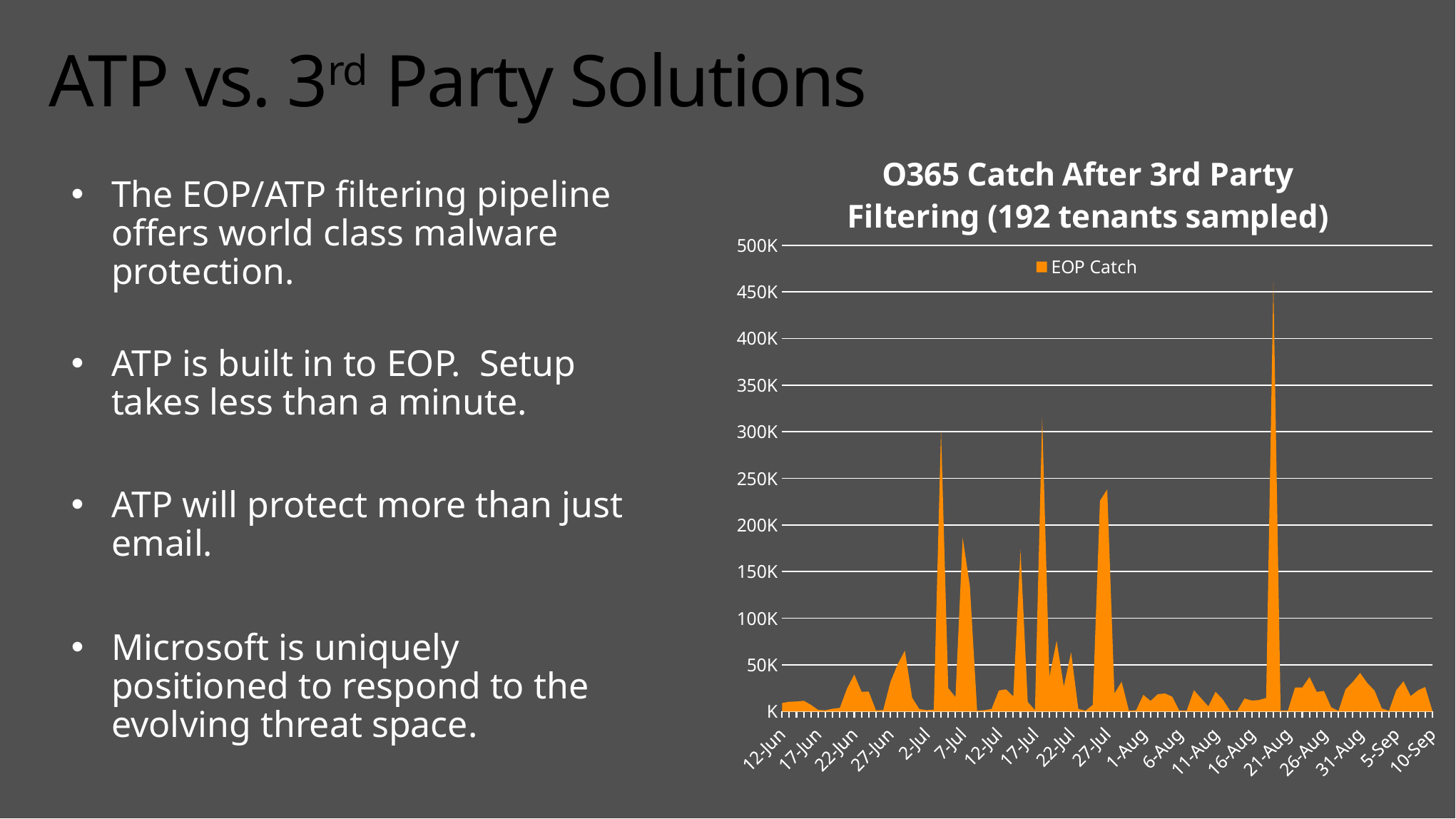
Is the value for 16-Aug greater or less than 50K? less Is the value for 10-Sep greater or less than 50K? less What kind of chart is shown on the slide? Area chart What is the title of the chart? O365 Catch After 3rd Party Filtering (192 tenants sampled) Is the value for 6-Aug greater or less than 100K? less How many date labels are shown along the x axis of the chart? 19 What is the highest value shown on the chart's y axis? 500K How many series does the chart's legend list? 1 What is the name of the series shown in the chart legend? EOP Catch Between which two x-axis labels does the tallest spike in the chart occur? 16-Aug and 21-Aug